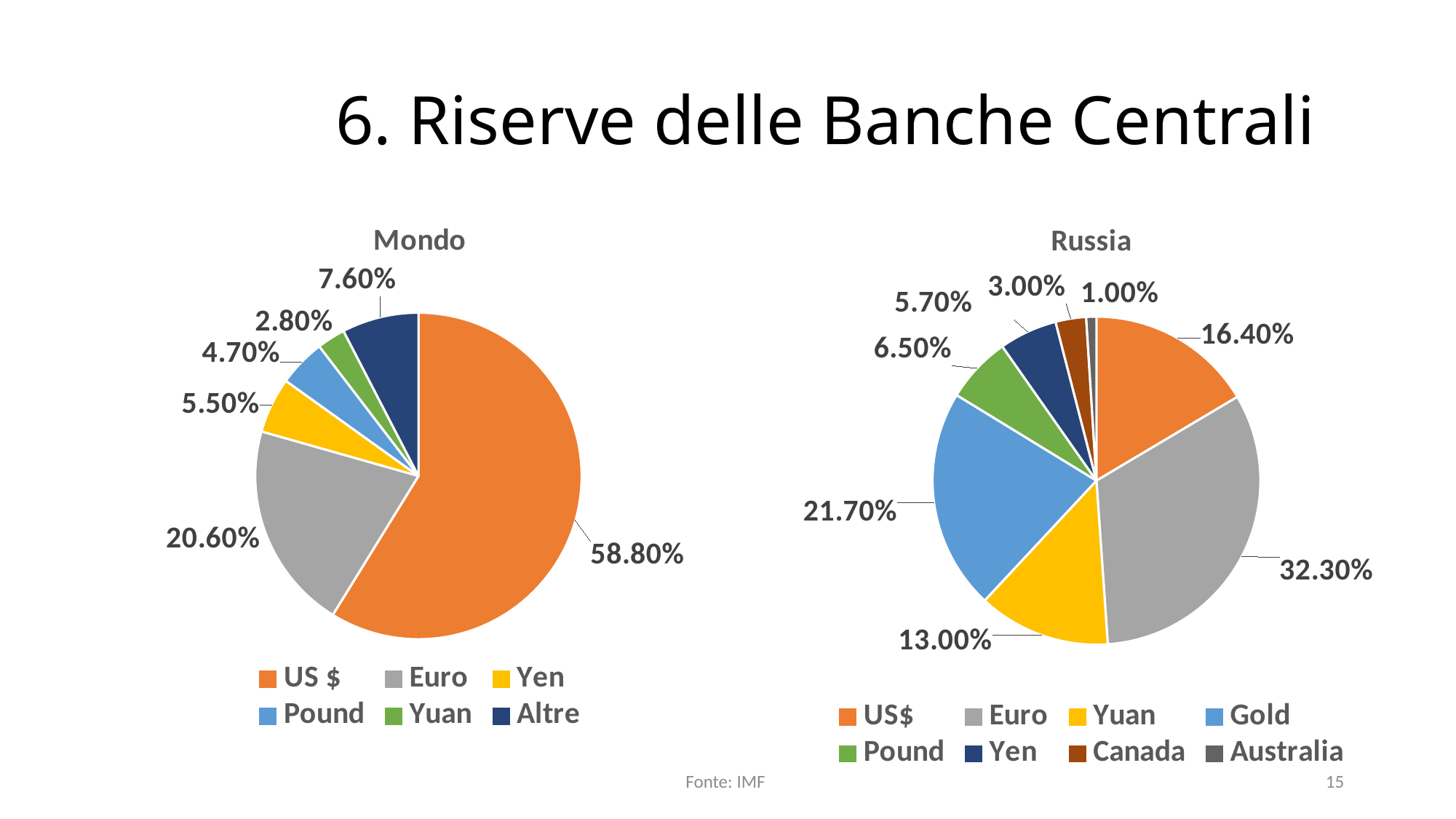
In the Mondo chart, what share is shown for Euro? 20.60% In the Russia chart, which category has the largest share? Euro In the Russia chart, which category has the smallest share? Australia In the Mondo chart, which category has the smallest share? Yuan In the Mondo chart, what share is shown for US $? 58.80% How many categories does the legend of the Russia chart list? 8 In the Russia chart, which is larger, the share for Yuan or the share for US$? US$ In the Mondo chart, what is the difference between the Yen share and the Pound share? 0.80% What type of chart is the Mondo chart? Pie chart In the Russia chart, what is the difference between the Euro share and the US$ share? 15.90% How many categories does the legend of the Mondo chart list? 6 In the Russia chart, what share is shown for Gold? 21.70%